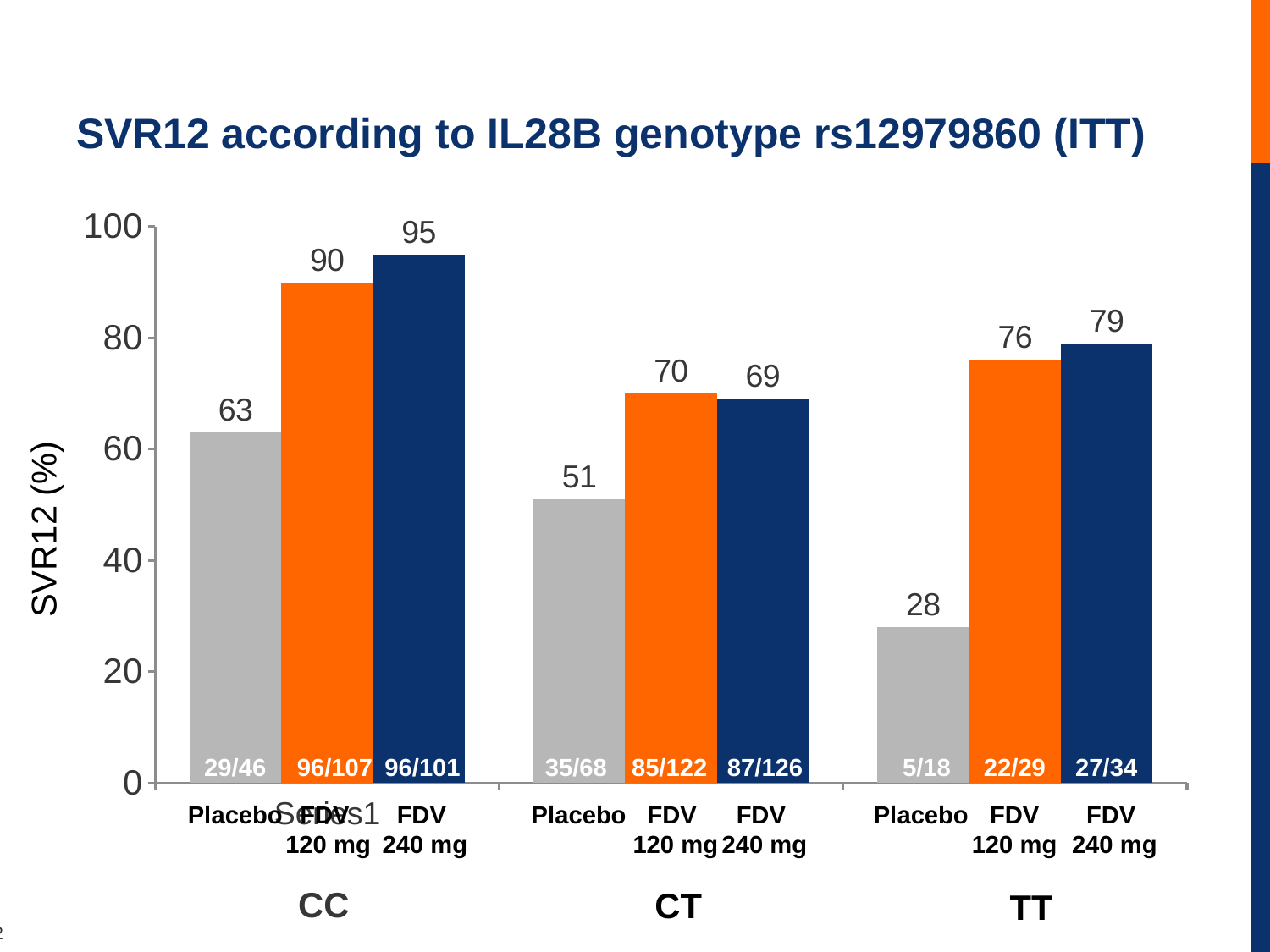
What is the label of the y axis? SVR12 (%) What is the difference in SVR12 between FDV 120 mg and Placebo in the CC genotype group? 27 What is the SVR12 value for Placebo in the TT genotype group? 28 Which bar has the highest SVR12 value on the chart? FDV 240 mg in the CC group What is the SVR12 value for FDV 240 mg in the CC genotype group? 95 What is the difference in SVR12 between FDV 240 mg and Placebo in the TT genotype group? 51 What is the SVR12 value for FDV 120 mg in the CT genotype group? 70 How many bars are plotted on the chart in total? 9 What fraction is printed inside the FDV 120 mg bar in the TT genotype group? 22/29 What kind of chart is shown on the slide? Bar chart Which is larger: the SVR12 for Placebo in the CC group or the SVR12 for Placebo in the CT group? Placebo in the CC group Which bar has the lowest SVR12 value on the chart? Placebo in the TT group